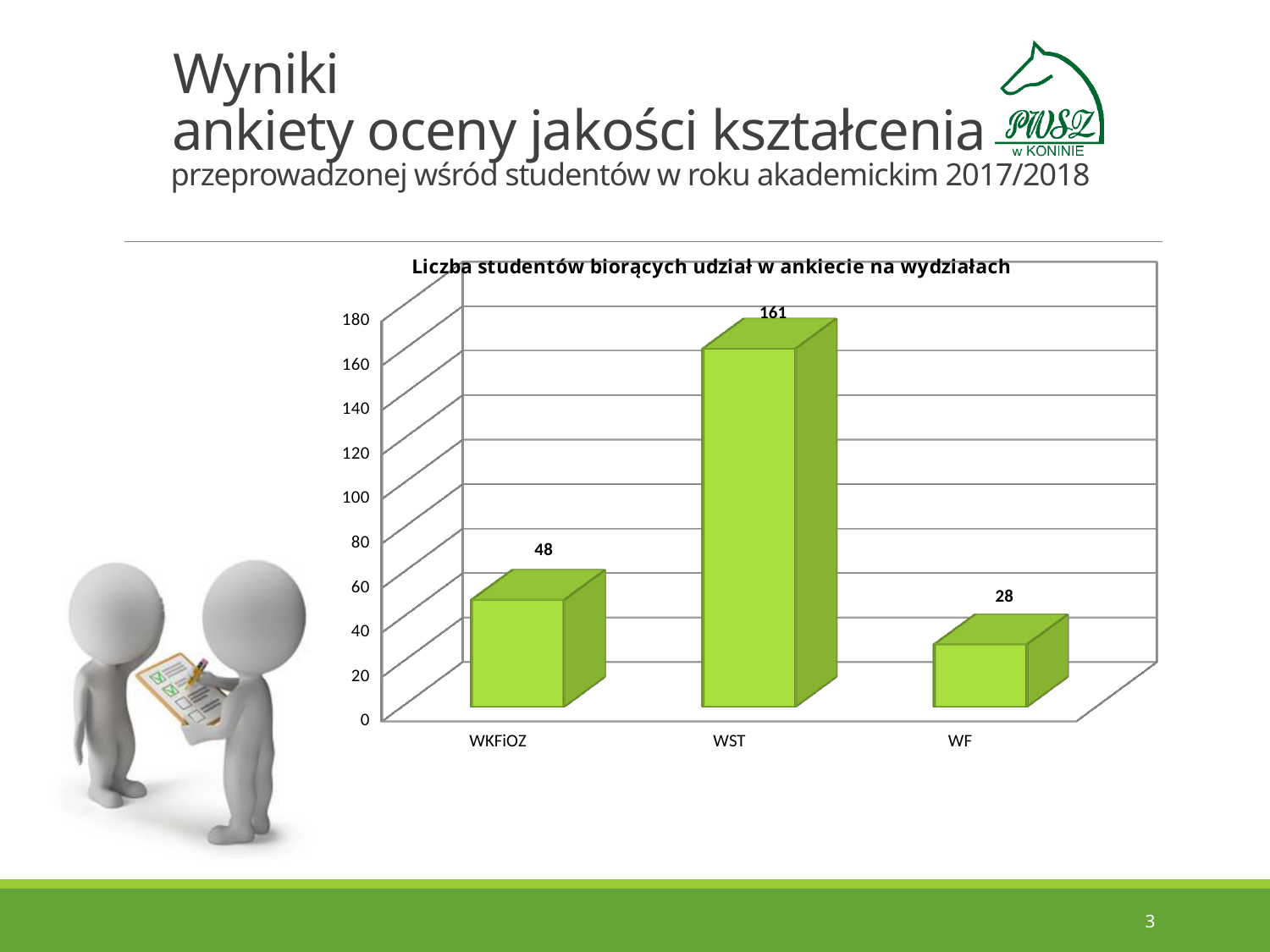
What is the value for WF? 28 How many categories are shown on the x axis? 3 What kind of chart is shown on the slide? bar chart Which category has the highest value? WST What is the difference between the values for WST and WKFiOZ? 113 What is the difference between the values for WKFiOZ and WF? 20 Which is larger, the value for WKFiOZ or the value for WF? WKFiOZ Is the value for WST greater or less than 140? greater Which category has the lowest value? WF What is the value for WKFiOZ? 48 What is the title of the chart? Liczba studentów biorących udział w ankiecie na wydziałach What is the value for WST? 161